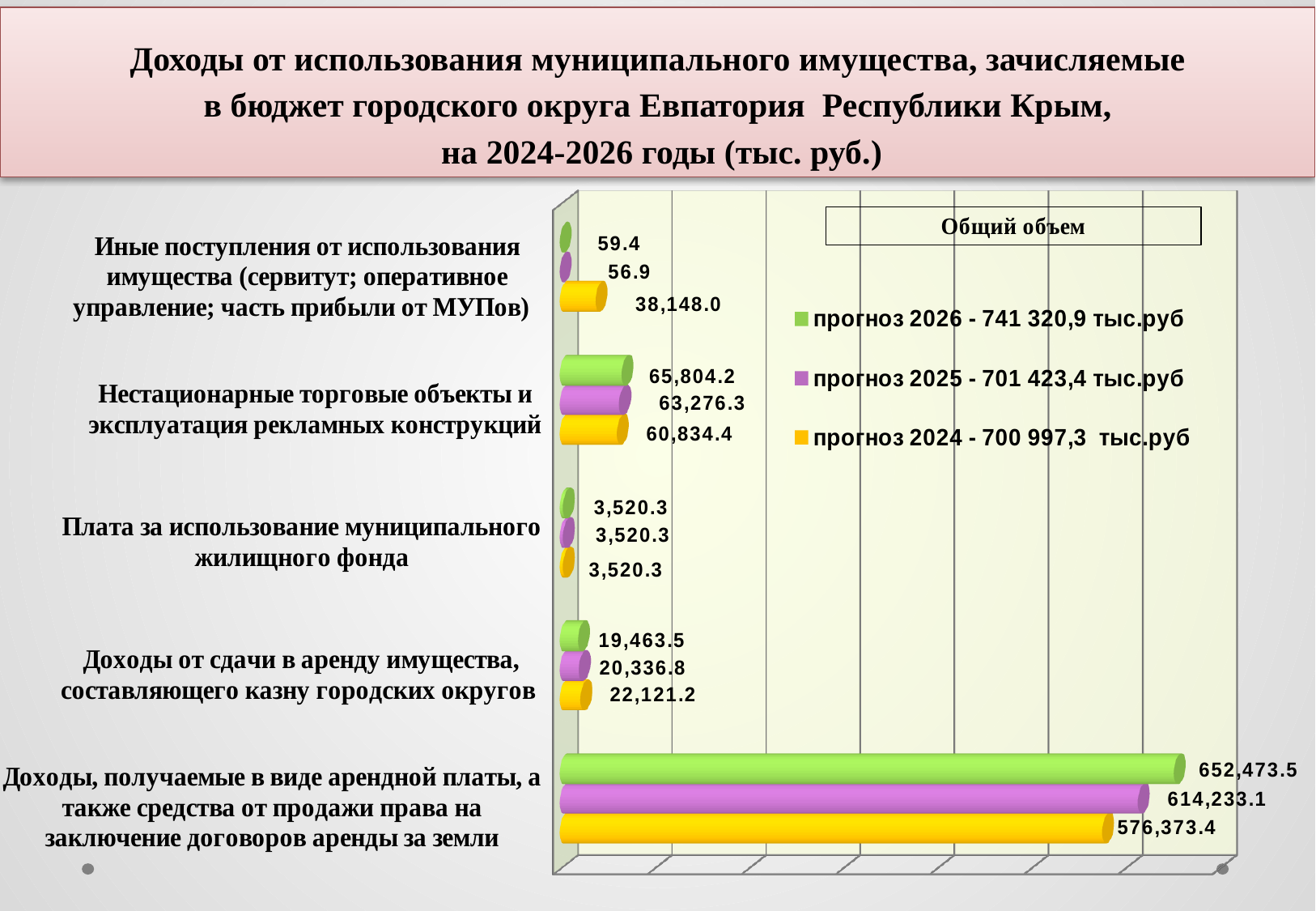
What is the прогноз 2025 value for 'Нестационарные торговые объекты и эксплуатация рекламных конструкций'? 63,276.3 How many series does the legend list? 3 For 'Доходы от сдачи в аренду имущества, составляющего казну городских округов', which is larger: the прогноз 2024 value or the прогноз 2026 value? прогноз 2024 Which category has the highest прогноз 2026 value? Доходы, получаемые в виде арендной платы, а также средства от продажи права на заключение договоров аренды за земли What kind of chart is shown on the slide? Bar chart How many categories are shown on the chart? 5 Which category has the lowest прогноз 2025 value? Иные поступления от использования имущества (сервитут; оперативное управление; часть прибыли от МУПов) What is the прогноз 2024 value for 'Доходы от сдачи в аренду имущества, составляющего казну городских округов'? 22,121.2 What is the прогноз 2026 value for 'Доходы, получаемые в виде арендной платы, а также средства от продажи права на заключение договоров аренды за земли'? 652,473.5 What is the difference between the прогноз 2026 and прогноз 2024 values for 'Нестационарные торговые объекты и эксплуатация рекламных конструкций'? 4,969.8 What is the прогноз 2024 value for 'Иные поступления от использования имущества (сервитут; оперативное управление; часть прибыли от МУПов)'? 38,148.0 What is the difference between the прогноз 2026 and прогноз 2024 values for 'Доходы, получаемые в виде арендной платы, а также средства от продажи права на заключение договоров аренды за земли'? 76,100.1